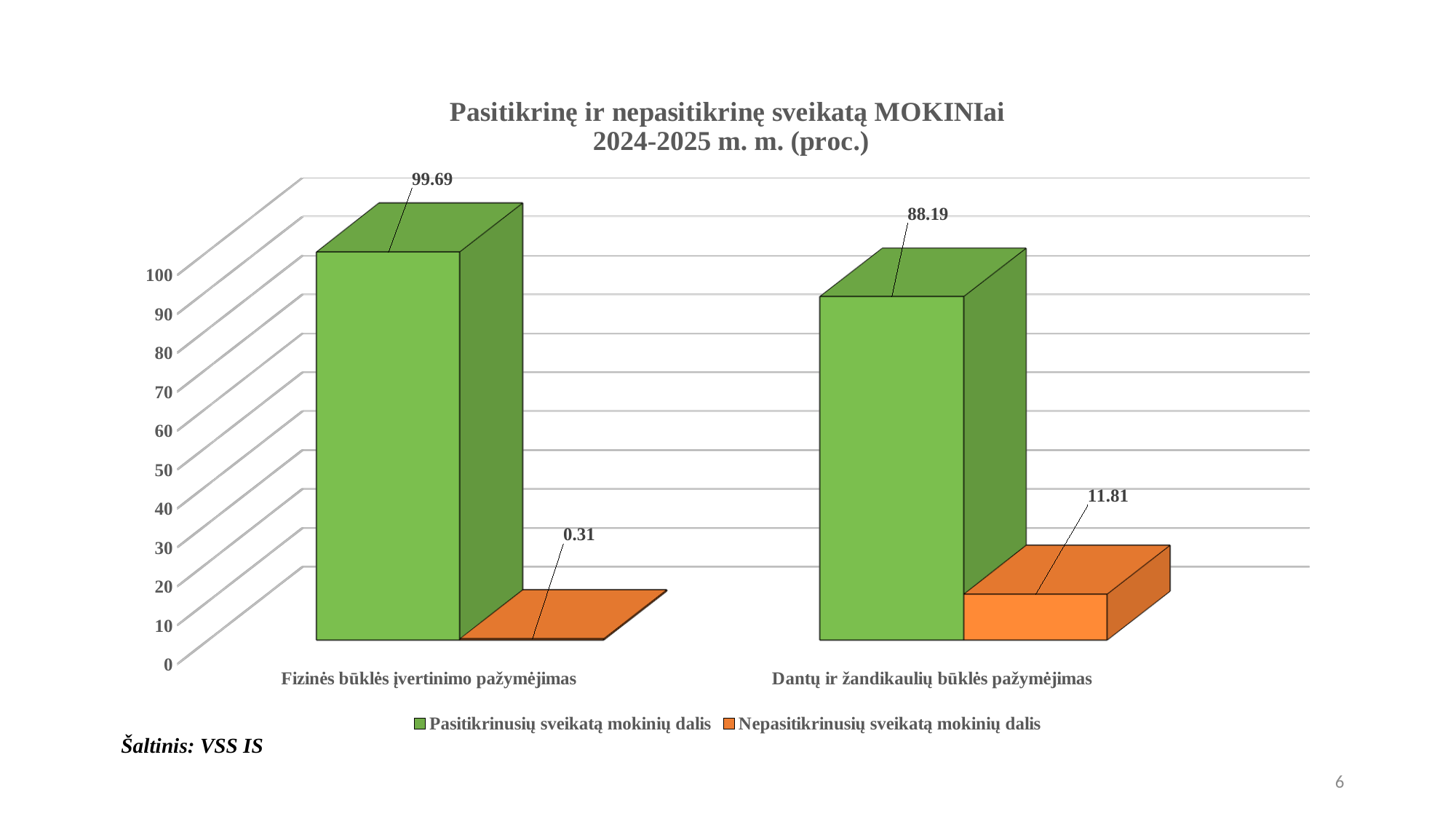
How many categories are shown on the x axis? 2 What is the value of Pasitikrinusių sveikatą mokinių dalis for Dantų ir žandikaulių būklės pažymėjimas? 88.19 What is the difference between the Pasitikrinusių sveikatą mokinių dalis values for Fizinės būklės įvertinimo pažymėjimas and Dantų ir žandikaulių būklės pažymėjimas? 11.50 What is the value of Nepasitikrinusių sveikatą mokinių dalis for Fizinės būklės įvertinimo pažymėjimas? 0.31 What kind of chart is shown on the slide? Bar chart How many series does the legend list? 2 What is the difference between the Nepasitikrinusių sveikatą mokinių dalis values for Dantų ir žandikaulių būklės pažymėjimas and Fizinės būklės įvertinimo pažymėjimas? 11.50 What is the value of Nepasitikrinusių sveikatą mokinių dalis for Dantų ir žandikaulių būklės pažymėjimas? 11.81 Which is larger: Pasitikrinusių sveikatą mokinių dalis or Nepasitikrinusių sveikatą mokinių dalis for Dantų ir žandikaulių būklės pažymėjimas? Pasitikrinusių sveikatą mokinių dalis Which category has the lowest value for Nepasitikrinusių sveikatą mokinių dalis? Fizinės būklės įvertinimo pažymėjimas Which category has the highest value for Pasitikrinusių sveikatą mokinių dalis? Fizinės būklės įvertinimo pažymėjimas What is the value of Pasitikrinusių sveikatą mokinių dalis for Fizinės būklės įvertinimo pažymėjimas? 99.69